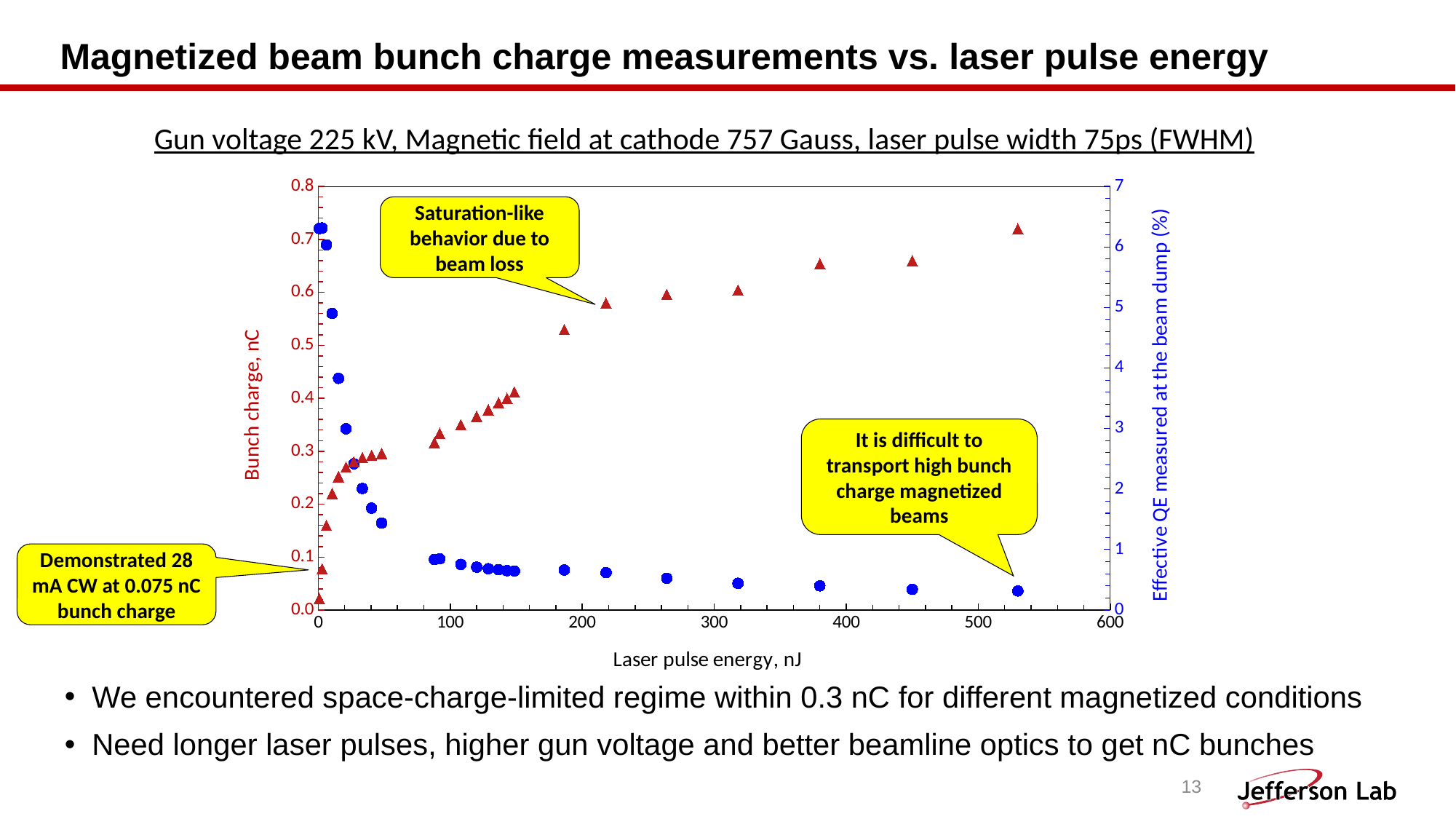
What is the label of the left y axis of the chart? Bunch charge, nC How does the effective QE (blue circles) change as laser pulse energy increases along the x axis? falls What is the label of the x axis of the chart? Laser pulse energy, nJ Is the bunch charge at about 100 nJ laser pulse energy greater or less than 0.2 nC? greater What is the maximum value shown on the right y axis (Effective QE) of the chart? 7 Is the effective QE at the highest laser pulse energy (around 530 nJ) greater or less than 1%? less Is the bunch charge at about 220 nJ laser pulse energy greater or less than 0.5 nC? greater What kind of chart is shown on the slide? scatter chart How does the bunch charge (red triangles) change as laser pulse energy increases along the x axis? rises At which end of the laser pulse energy range is the effective QE highest, the lowest energies or the highest energies? the lowest energies